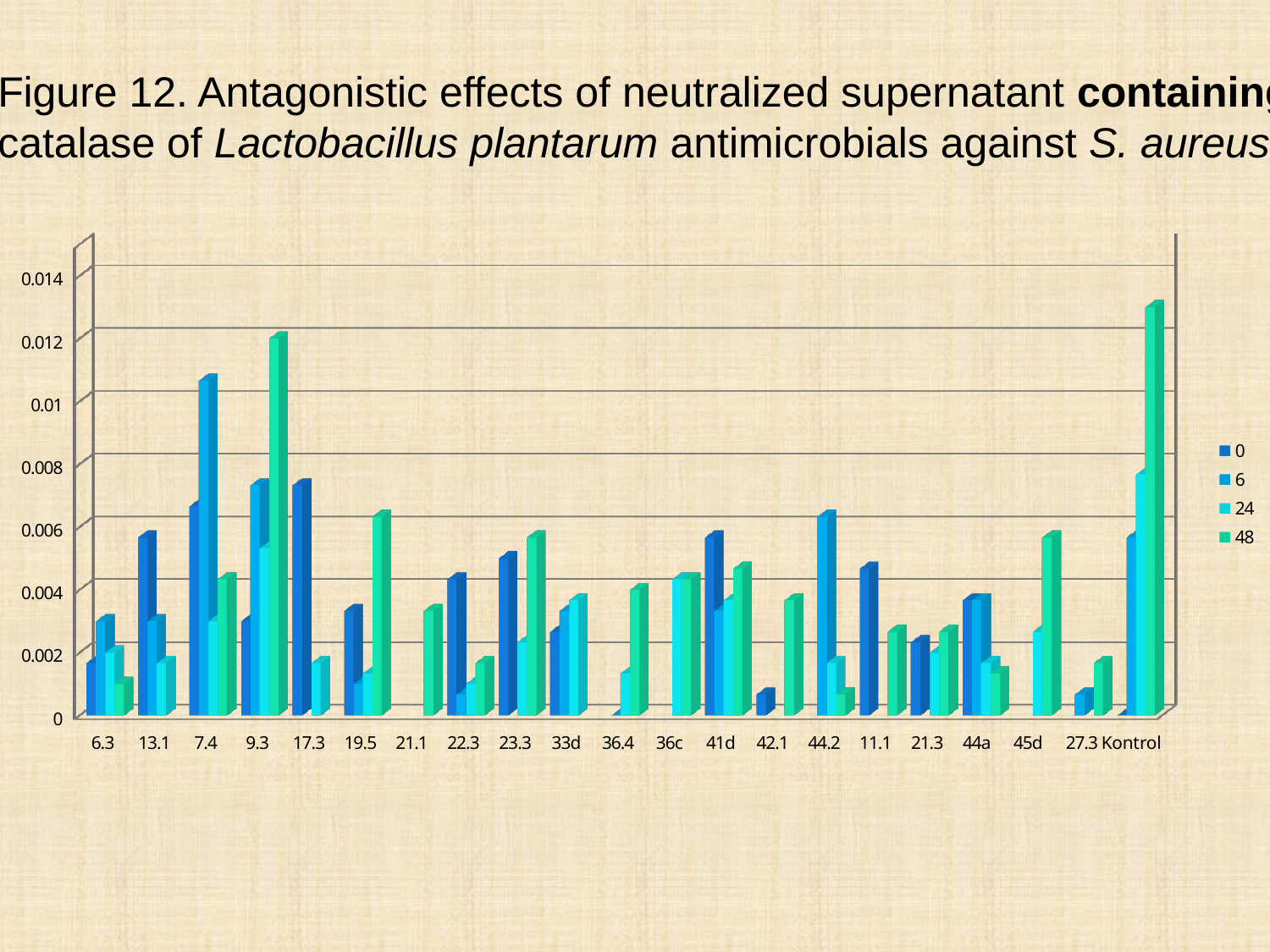
Which category has the tallest bar in the chart? Kontrol What kind of chart is shown on the slide? bar chart For the Kontrol category, which series has the tallest bar? 48 Which is larger: the series 48 value for Kontrol or the series 6 value for category 7.4? Kontrol Is the value of series 48 for Kontrol greater or less than 0.012? greater Is the value of series 6 for category 7.4 greater or less than 0.01? greater Is the value of series 6 for category 44.2 greater or less than 0.004? greater How many series does the legend list? 4 Which is larger: the series 0 value for category 17.3 or the series 0 value for category 19.5? 17.3 What are the series names listed in the legend? 0, 6, 24, 48 How many categories are shown along the x axis? 21